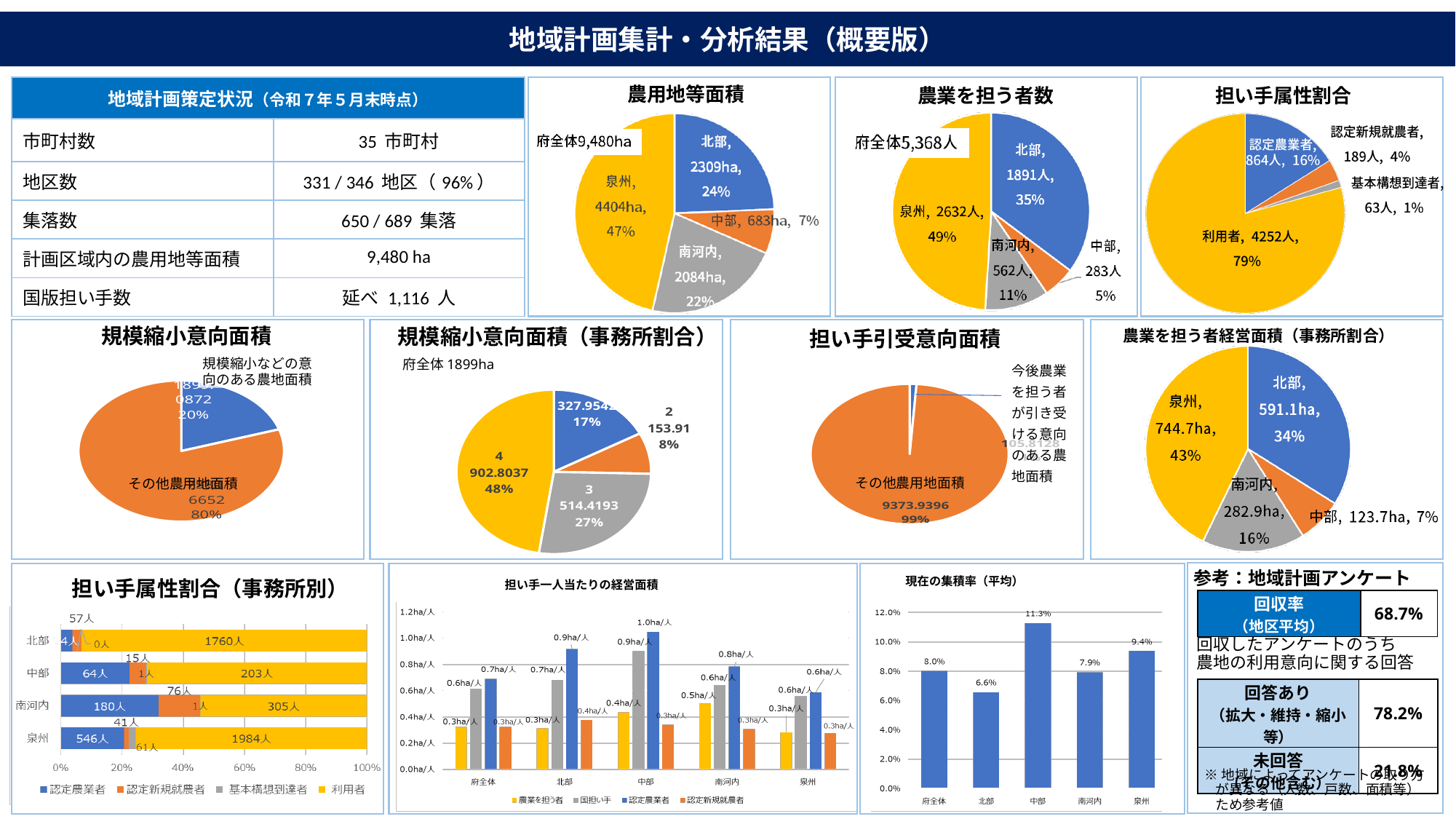
In the 農業を担う者数 pie chart, which region has the smallest number of people? 中部 In the 農業を担う者経営面積（事務所割合） pie chart, what is the value for 南河内? 282.9ha In the 農業を担う者数 pie chart, what is the difference in people between 泉州 and 北部? 741人 In the 農用地等面積 pie chart, what is the value for 泉州? 4404ha In the 現在の集積率（平均） bar chart, what is the value for 中部? 11.3% In the 担い手属性割合（事務所別） stacked bar chart, how many series does the legend list? 4 In the 担い手属性割合 pie chart, what is the value for 認定農業者? 864人 In the 担い手一人当たりの経営面積 bar chart, what is the value for 認定農業者 in 中部? 1.0ha/人 In the 農用地等面積 pie chart, what share of the pie does 北部 hold? 24% In the 農業を担う者経営面積（事務所割合） pie chart, which region has the largest area? 泉州 In the 現在の集積率（平均） bar chart, which region has the lowest value? 北部 In the 現在の集積率（平均） bar chart, how many categories are shown on the x axis? 5